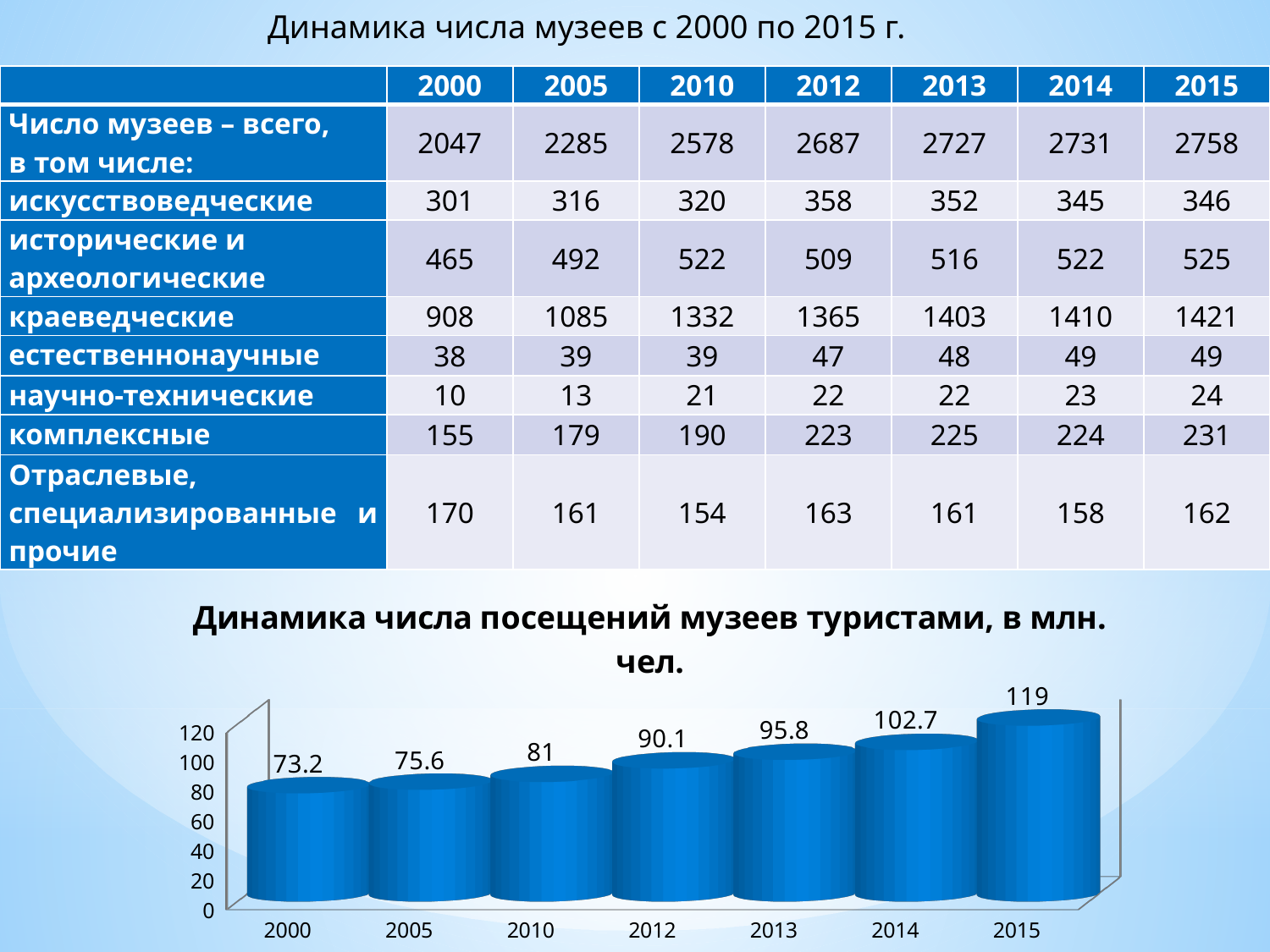
In the chart "Динамика числа посещений музеев туристами, в млн. чел.", is the value for 2014 greater or less than 100? greater What is the value for 2013 in the chart "Динамика числа посещений музеев туристами, в млн. чел."? 95.8 What kind of chart is "Динамика числа посещений музеев туристами, в млн. чел."? bar chart In the chart "Динамика числа посещений музеев туристами, в млн. чел.", what is the difference between the values for 2012 and 2010? 9.1 What is the value for 2000 in the chart "Динамика числа посещений музеев туристами, в млн. чел."? 73.2 Which year has the lowest value in the chart "Динамика числа посещений музеев туристами, в млн. чел."? 2000 What is the value for 2015 in the chart "Динамика числа посещений музеев туристами, в млн. чел."? 119 Which year has the highest value in the chart "Динамика числа посещений музеев туристами, в млн. чел."? 2015 In the chart "Динамика числа посещений музеев туристами, в млн. чел.", which is larger: the value for 2005 or the value for 2013? 2013 In the chart "Динамика числа посещений музеев туристами, в млн. чел.", what is the difference between the values for 2015 and 2014? 16.3 How many years are shown on the x axis of the chart "Динамика числа посещений музеев туристами, в млн. чел."? 7 In the chart "Динамика числа посещений музеев туристами, в млн. чел.", do the values rise or fall from 2000 to 2015? rise